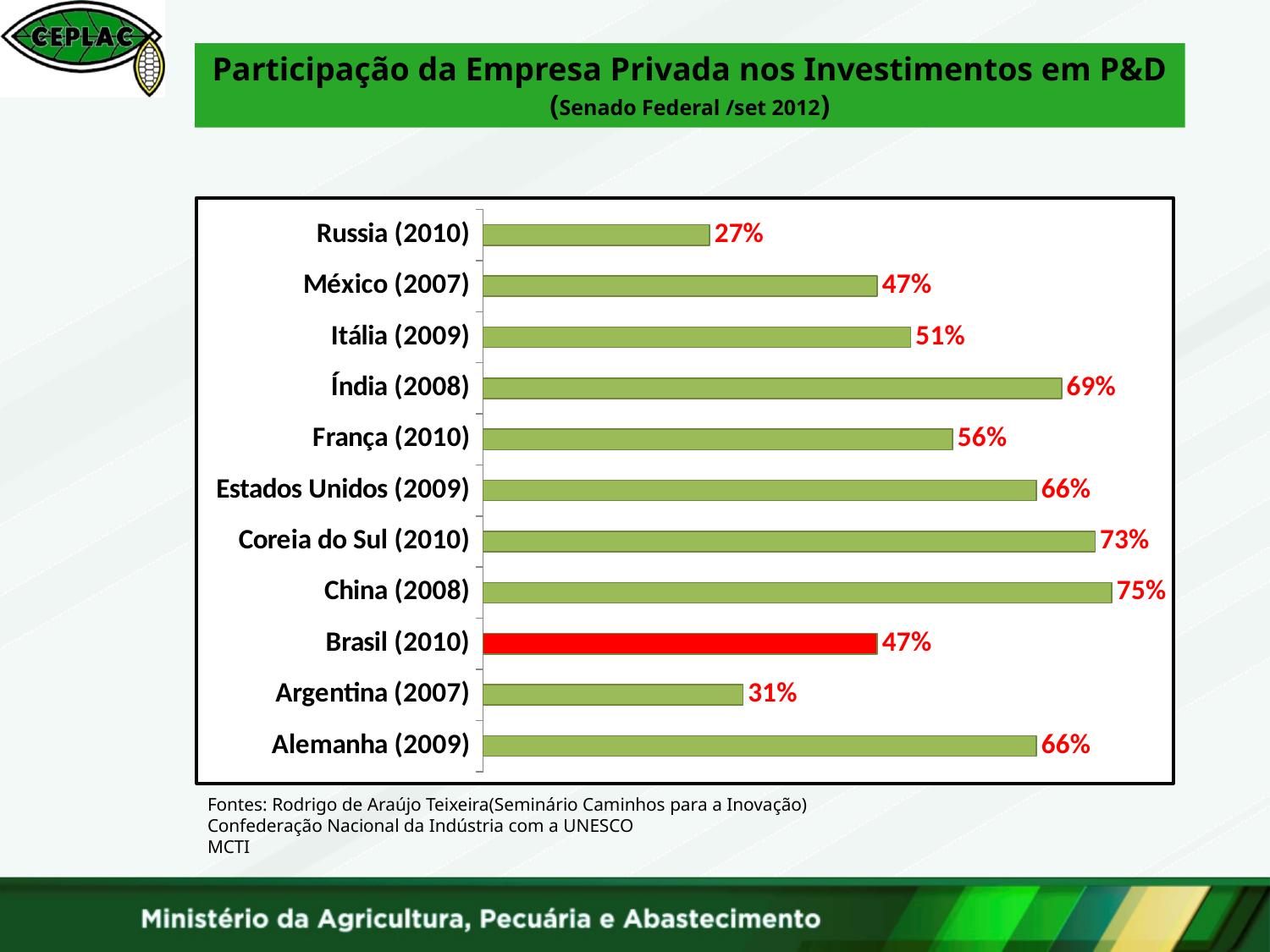
What is the difference between the values for China (2008) and Brasil (2010)? 28% What kind of chart is shown on the slide? Bar chart What is the difference between the values for Argentina (2007) and Russia (2010)? 4% Which bar is coloured red instead of green? Brasil (2010) What is the title of the chart? Participação da Empresa Privada nos Investimentos em P&D How many categories are shown in the chart? 11 Which is larger, the value for Índia (2008) or the value for França (2010)? Índia (2008) What is the value for Brasil (2010)? 47% Which category has the highest value? China (2008) What is the value for Coreia do Sul (2010)? 73% What is the value for Russia (2010)? 27% Which category has the lowest value? Russia (2010)